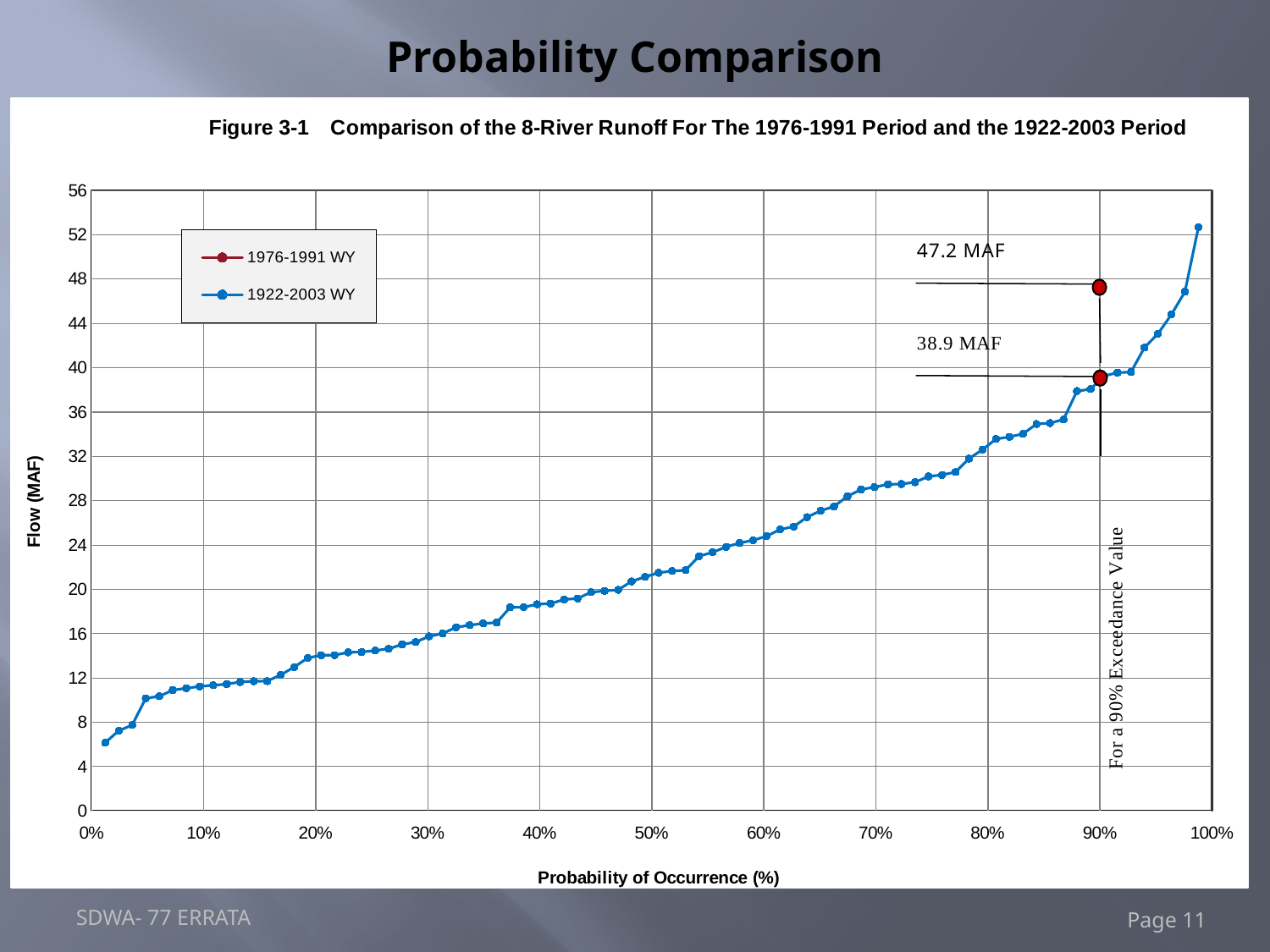
Is the value of the 1922-2003 WY line at 30% probability greater or less than 20 MAF? less What is the difference between the two labelled values at the 90% exceedance line, 47.2 MAF and 38.9 MAF? 8.3 MAF Does the 1922-2003 WY line rise or fall as probability of occurrence increases along the x axis? rises What is the label on the x axis of the chart? Probability of Occurrence (%) How many series does the legend list? 2 What is the figure title shown above the chart? Figure 3-1 Comparison of the 8-River Runoff For The 1976-1991 Period and the 1922-2003 Period What is the upper labelled flow value marked at the 90% exceedance line? 47.2 MAF Is the value of the 1922-2003 WY line at 80% probability greater or less than 28 MAF? greater What is the lower labelled flow value marked at the 90% exceedance line? 38.9 MAF Is the value of the 1922-2003 WY line at 50% probability greater or less than 24 MAF? less What kind of chart is shown on the slide? line chart Which of the two labelled values at the 90% exceedance line is larger, 47.2 MAF or 38.9 MAF? 47.2 MAF